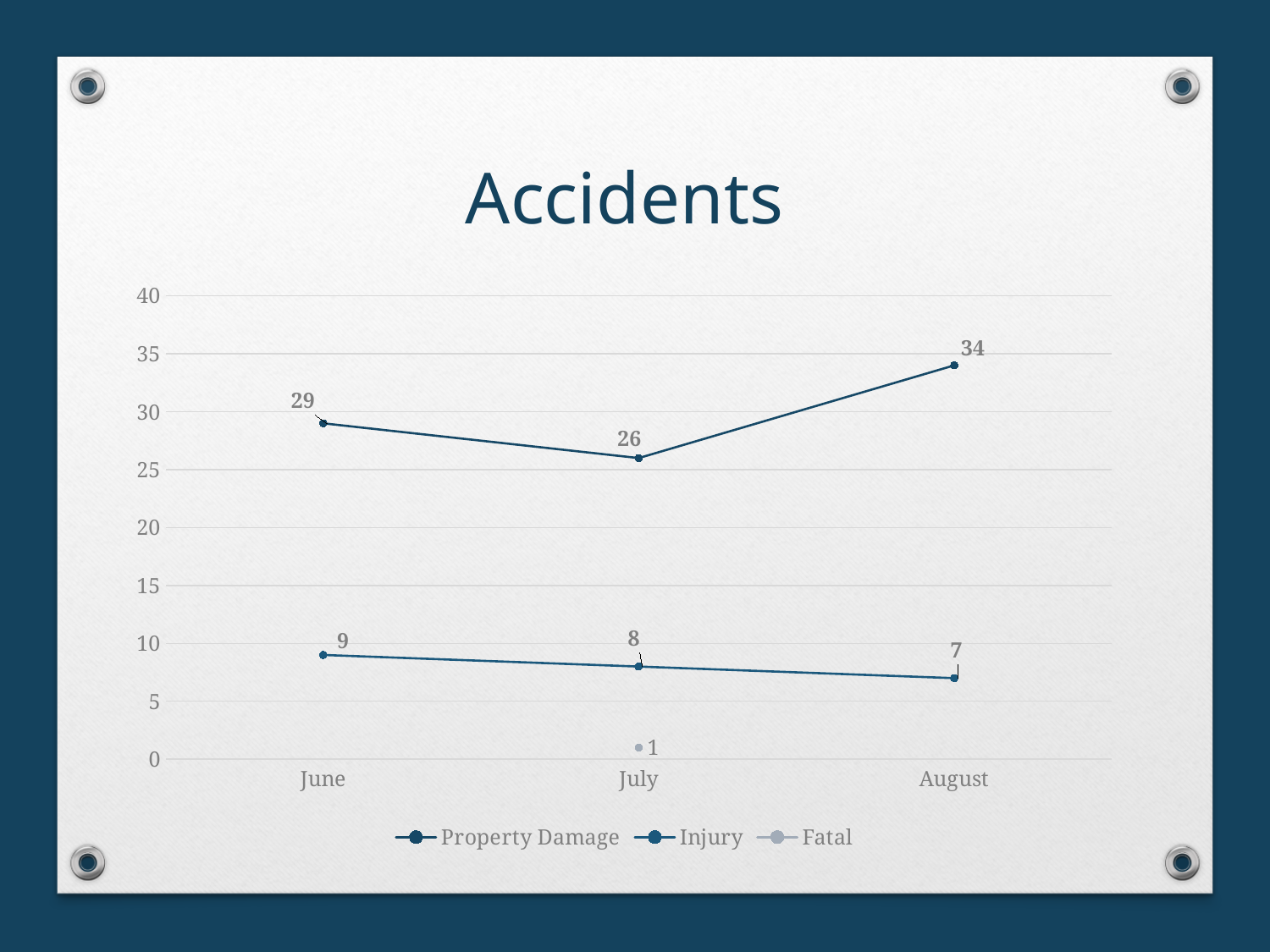
How many series does the legend list? 3 Which is larger: Property Damage in June or Injury in June? Property Damage in June Is the Property Damage value for July greater or less than 30? less What is the Property Damage value for August? 34 In which month is Injury lowest? August What kind of chart is shown? line chart How many months are shown on the x axis? 3 What is the difference between Property Damage in August and in July? 8 What is the Injury value for June? 9 What is the Fatal value for July? 1 Does the Injury series rise or fall from June to August? fall In which month is Property Damage highest? August